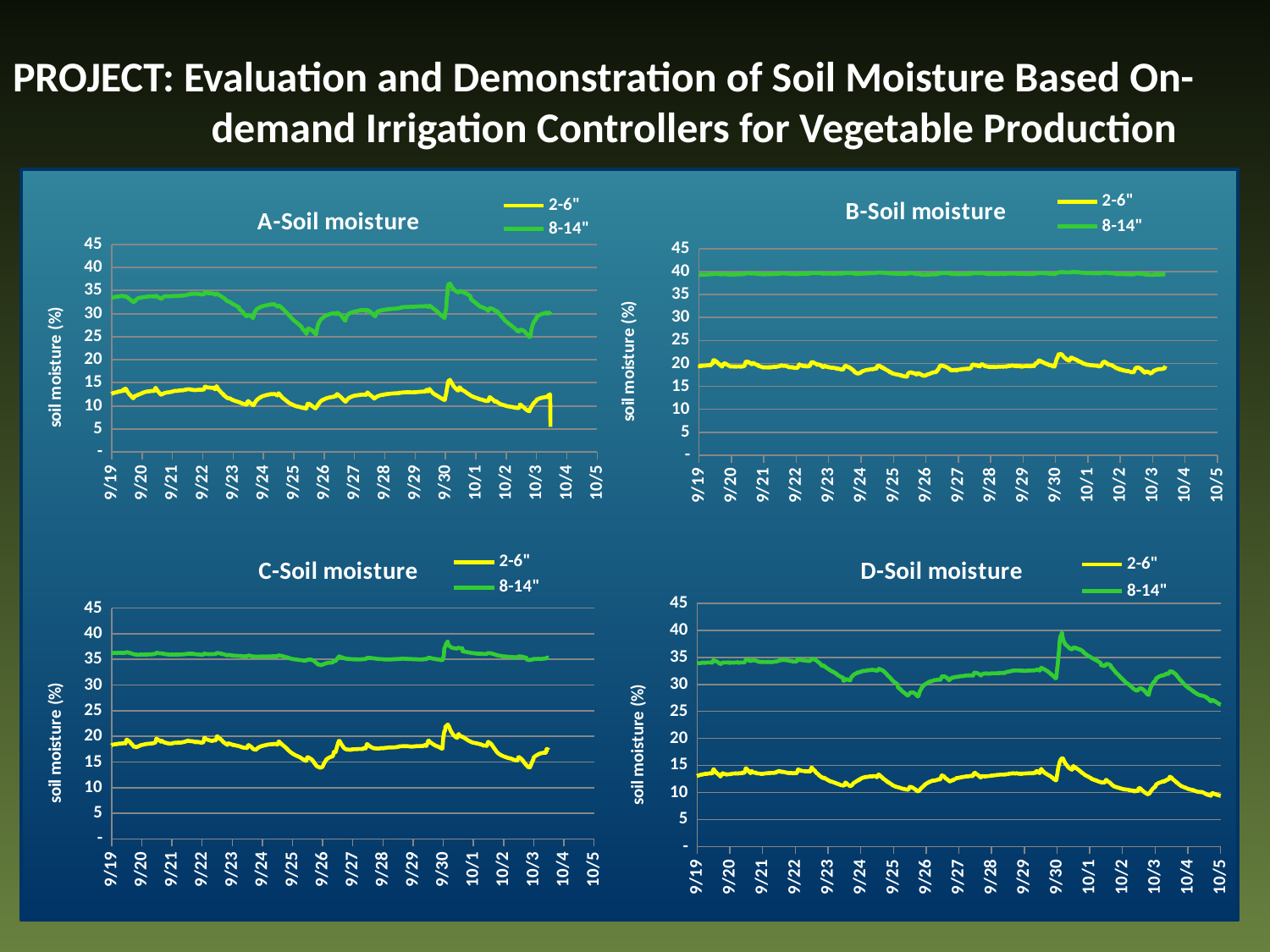
In the D-Soil moisture chart, which series is higher on 9/30, 2-6" or 8-14"? 8-14" What kind of chart is the A-Soil moisture chart? line chart In the C-Soil moisture chart, is the value of the 2-6" series on 9/19 greater or less than 25? less In the D-Soil moisture chart, is the value of the 2-6" series on 10/5 greater or less than 15? less In the B-Soil moisture chart, is the value of the 8-14" series on 9/25 greater or less than 35? greater In the B-Soil moisture chart, which series has higher values throughout, 2-6" or 8-14"? 8-14" How many charts are shown on the slide? 4 What are the two series named in the legend of the C-Soil moisture chart? 2-6" and 8-14" What is the y-axis label on the D-Soil moisture chart? soil moisture (%) How many series does the legend of the B-Soil moisture chart list? 2